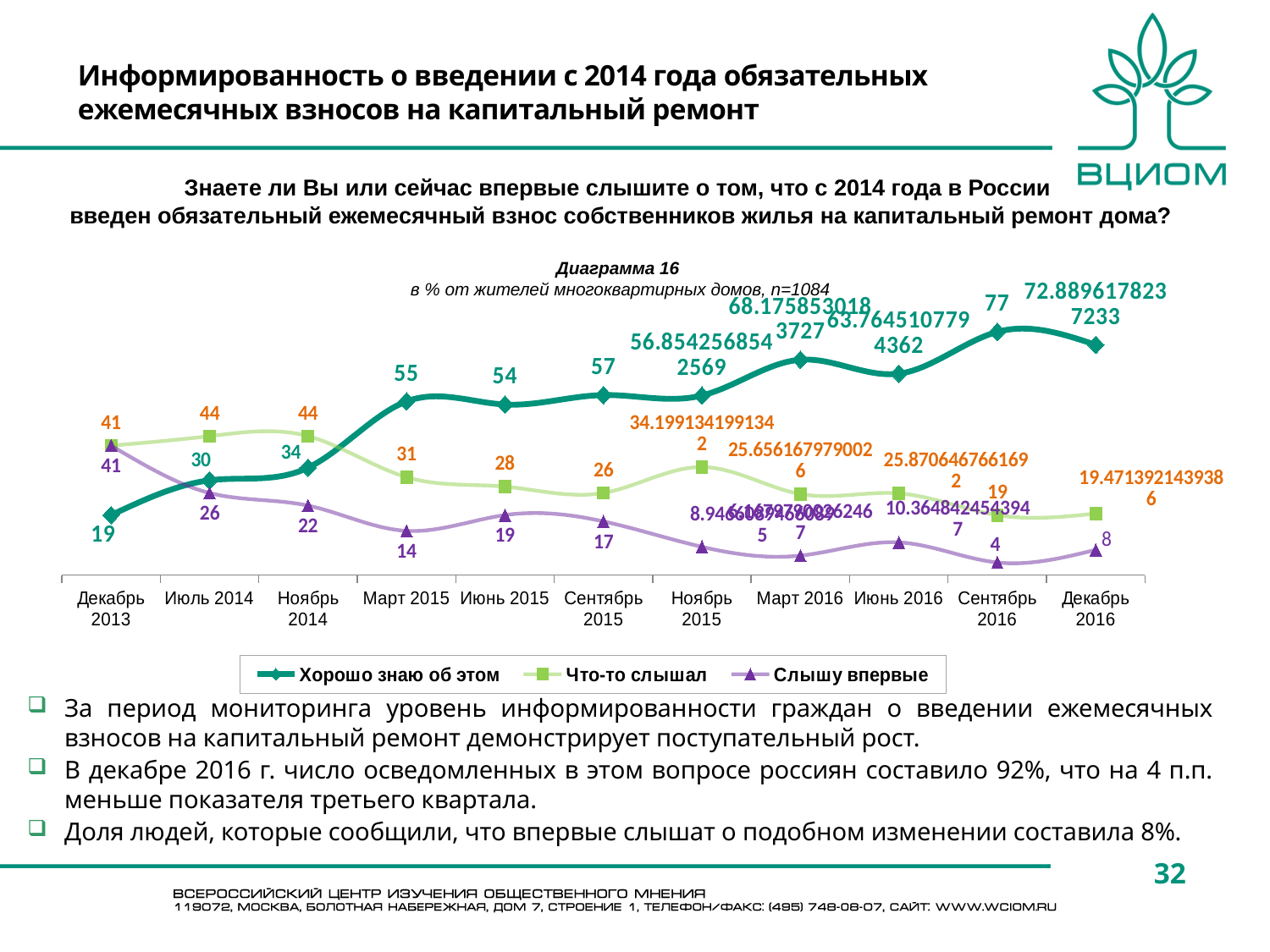
What is the difference between "Хорошо знаю об этом" in Март 2015 and in Ноябрь 2014? 21 What is the value for "Что-то слышал" in Март 2015? 31 What kind of chart is shown on the slide? line chart What is the value for "Слышу впервые" in Декабрь 2016? 8 Which is larger in Июль 2014: "Что-то слышал" or "Хорошо знаю об этом"? Что-то слышал How many series does the legend list? 3 What is the value for "Хорошо знаю об этом" in Декабрь 2013? 19 Does the "Слышу впервые" series generally rise or fall from Декабрь 2013 to Декабрь 2016? fall What is the value for "Хорошо знаю об этом" in Сентябрь 2016? 77 At which time point is the "Хорошо знаю об этом" series highest? Сентябрь 2016 At which time point is the "Слышу впервые" series lowest? Сентябрь 2016 How many time points are plotted along the x axis? 11